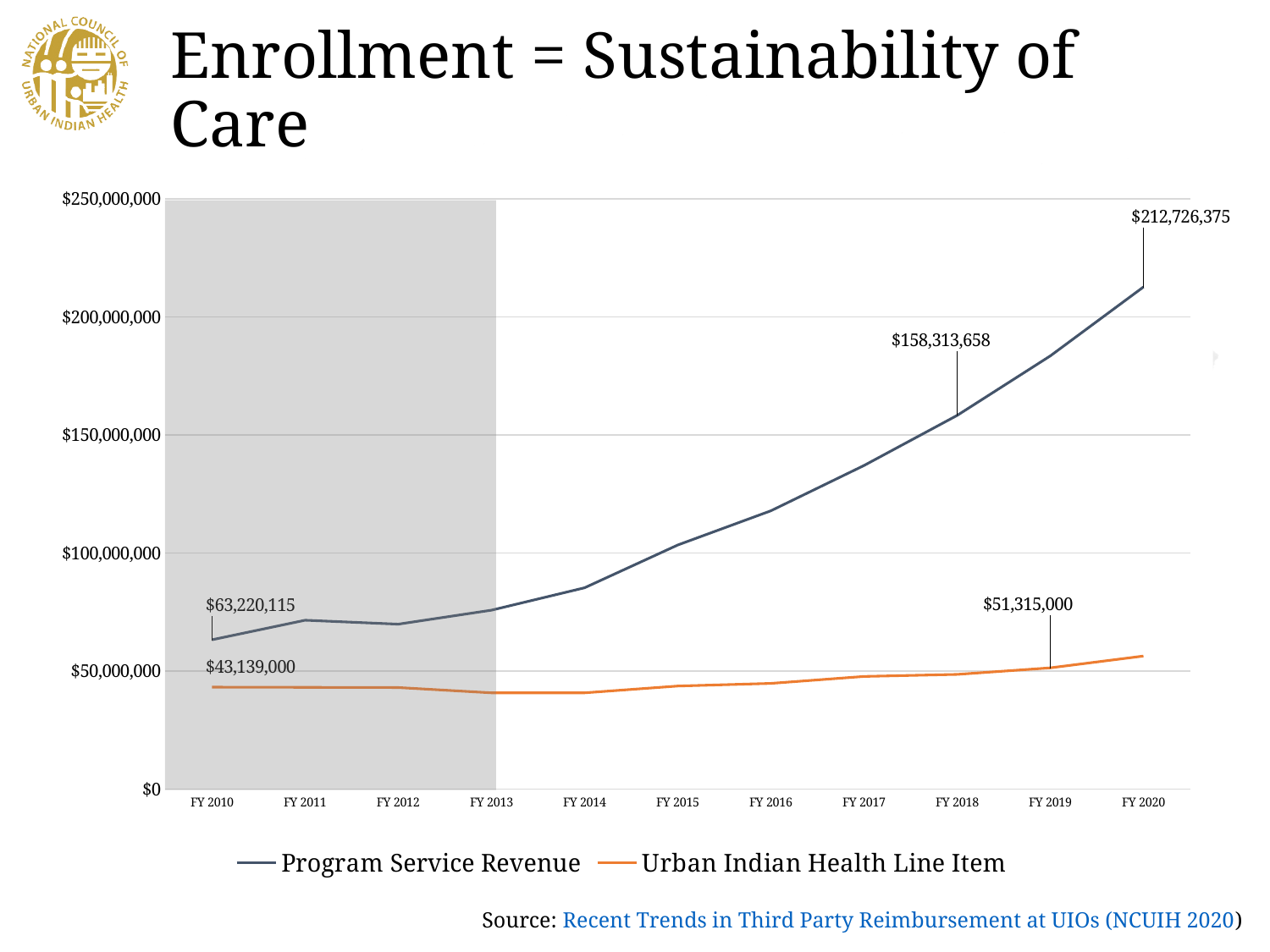
What is the Program Service Revenue value labeled for FY 2020? $212,726,375 What is the Urban Indian Health Line Item value labeled for FY 2019? $51,315,000 By how much did Program Service Revenue grow from FY 2010 to FY 2020, using the labeled values? $149,506,260 What is the Urban Indian Health Line Item value labeled for FY 2010? $43,139,000 What is the Program Service Revenue value labeled for FY 2010? $63,220,115 Which series has the higher value in FY 2020, Program Service Revenue or Urban Indian Health Line Item? Program Service Revenue How many series does the legend list? 2 What kind of chart is shown on the slide? line chart How many fiscal years are plotted along the x axis? 11 Does Program Service Revenue generally rise or fall from FY 2013 to FY 2020? rise What is the Program Service Revenue value labeled for FY 2018? $158,313,658 Is the Program Service Revenue value for FY 2016 greater or less than $100,000,000? greater